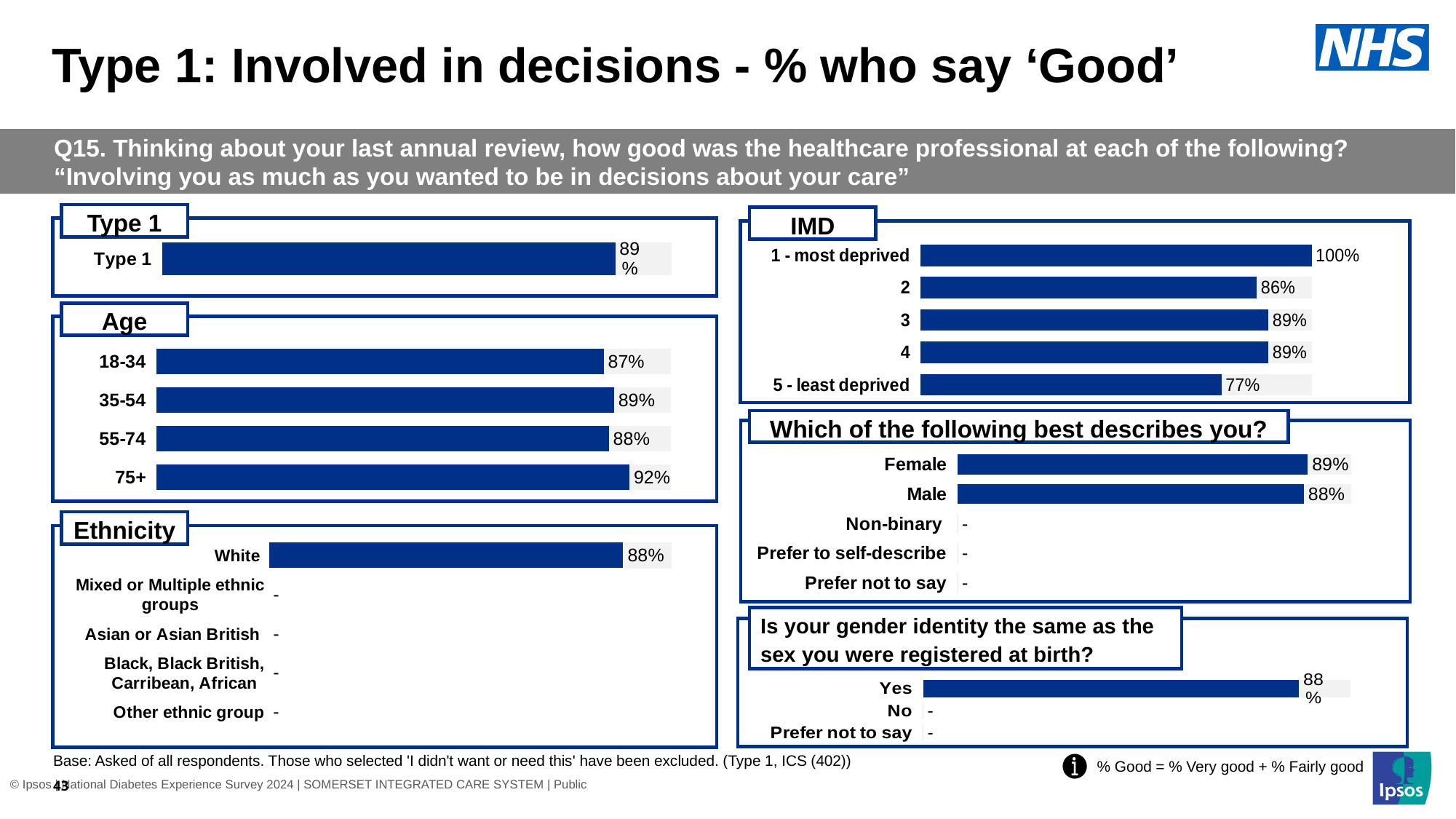
In the Ethnicity chart, what is the value for White? 88% In the Age chart, which age group has the highest value? 75+ In the IMD chart, which is larger: the value for 2 or the value for 3? 3 In the 'Is your gender identity the same as the sex you were registered at birth?' chart, what is the value for Yes? 88% How many categories are shown in the IMD chart? 5 In the Age chart, what is the value for the 75+ age group? 92% In the Age chart, which age group has the lowest value? 18-34 What kind of chart is used in the Age section? Bar chart In the IMD chart, which category has the lowest value? 5 - least deprived In the IMD chart, what is the value for '1 - most deprived'? 100% In the 'Which of the following best describes you?' chart, what is the value for Female? 89% In the IMD chart, what is the difference between the values for '1 - most deprived' and '5 - least deprived'? 23%